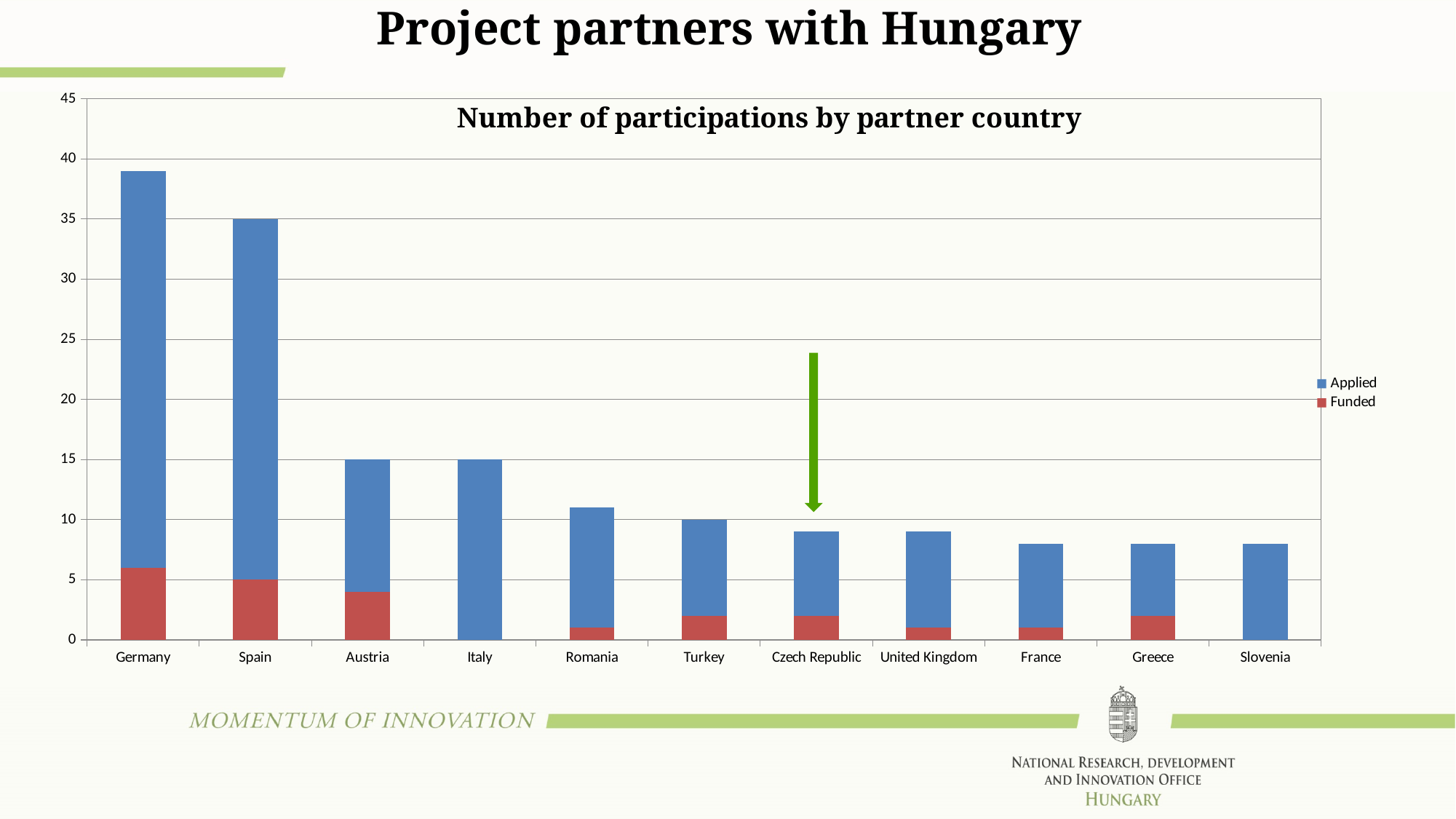
Do the Applied values rise or fall from left to right along the x axis? fall What type of chart is shown on the slide? bar chart What is the Applied value for Italy? 15 How many series does the legend list? 2 What is the title of the chart? Number of participations by partner country What is the Funded value for Spain? 5 Which country has the highest Applied value? Germany How many partner countries are shown on the x axis? 11 What is the Applied value for Spain? 30